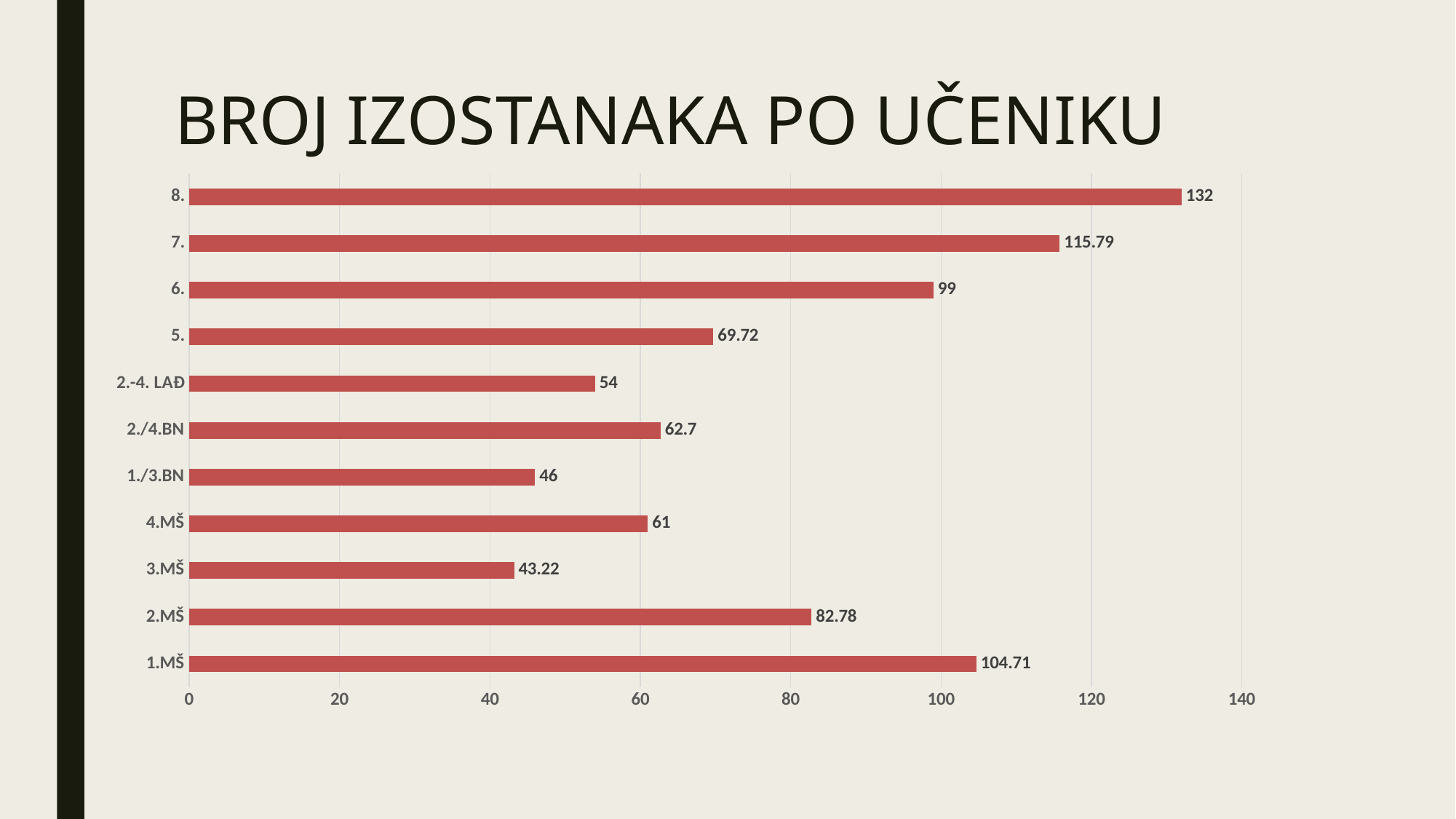
What is the difference between the values for 2./4.BN and 2.-4. LAĐ? 8.7 What is the value for 8.? 132 What kind of chart is shown on the slide? bar chart Is the value for 7. greater or less than 100? greater Which category has the lowest value? 3.MŠ What is the title of the chart on the slide? BROJ IZOSTANAKA PO UČENIKU How many categories are shown in the chart? 11 Which category has the highest value? 8. What is the value for 2.MŠ? 82.78 What is the difference between the values for 8. and 6.? 33 Which is larger, the value for 1.MŠ or the value for 6.? 1.MŠ What is the value for 1./3.BN? 46